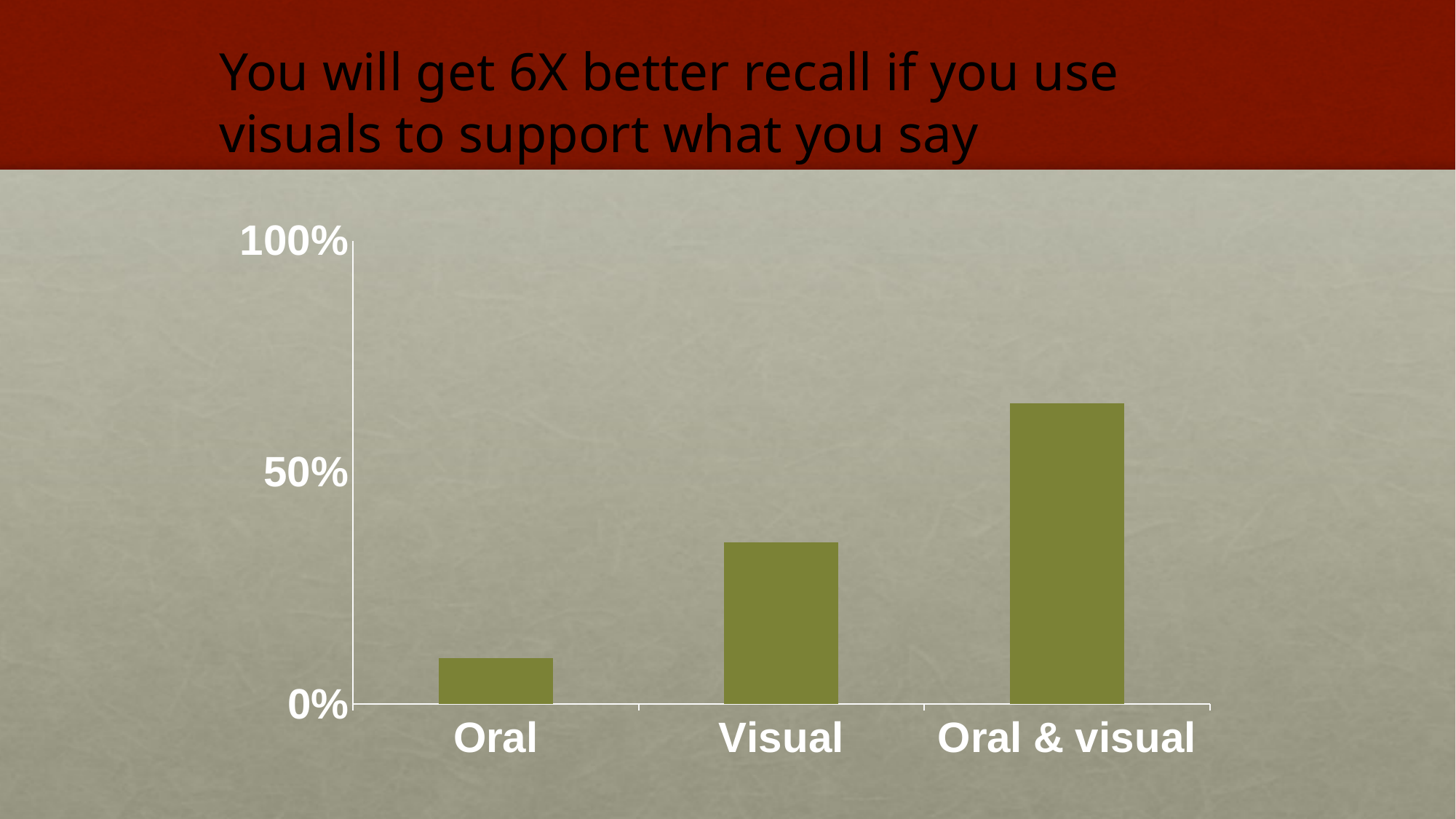
Which category has the highest bar? Oral & visual Which is larger, the value for Oral & visual or the value for Visual? Oral & visual How many categories are plotted on the chart? 3 Is the value for Visual greater or less than 50%? less Is the value for Oral greater or less than 50%? less Which category has the lowest bar? Oral Do the bar values rise or fall from left to right across the categories? rise Is the value for Oral & visual greater or less than 50%? greater Which is larger, the value for Visual or the value for Oral? Visual What kind of chart is shown on the slide? bar chart What is the label of the rightmost category on the x axis? Oral & visual What is the highest value shown on the vertical axis? 100%